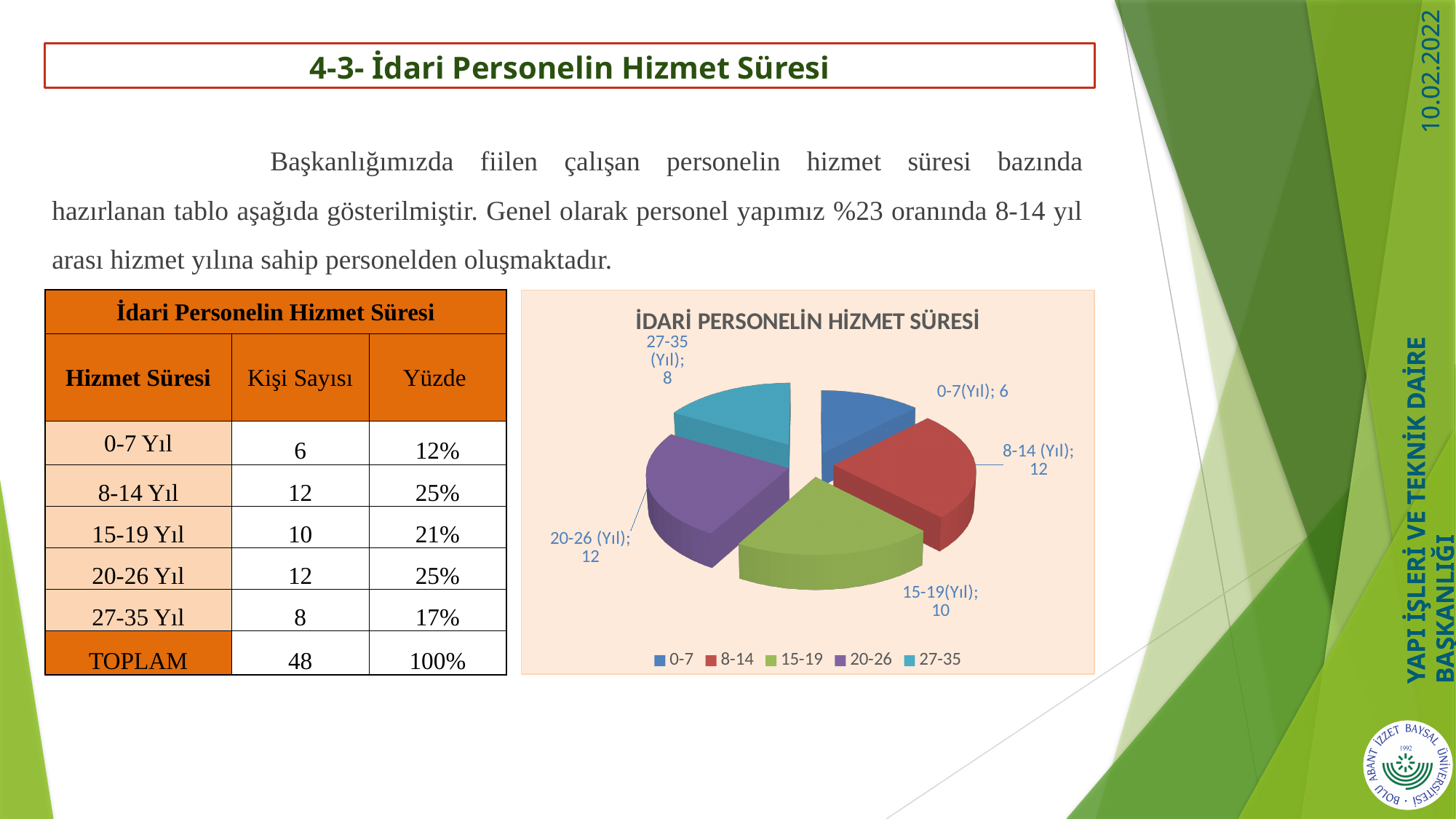
How many slices does the pie chart have? 5 What is the title of the chart? İDARİ PERSONELİN HİZMET SÜRESİ What is the value for the 27-35 (Yıl) slice? 8 What is the value for the 15-19 (Yıl) slice? 10 What kind of chart is shown on the slide? pie chart Which category has the smallest slice in the pie chart? 0-7 (Yıl) Which is larger, the 15-19 (Yıl) slice or the 27-35 (Yıl) slice? 15-19 (Yıl) What is the difference between the 8-14 (Yıl) value and the 0-7 (Yıl) value? 6 How many entries does the chart legend list? 5 What share of the pie does the 8-14 (Yıl) slice represent? 25% What is the value for the 8-14 (Yıl) slice? 12 What is the value for the 0-7 (Yıl) slice? 6